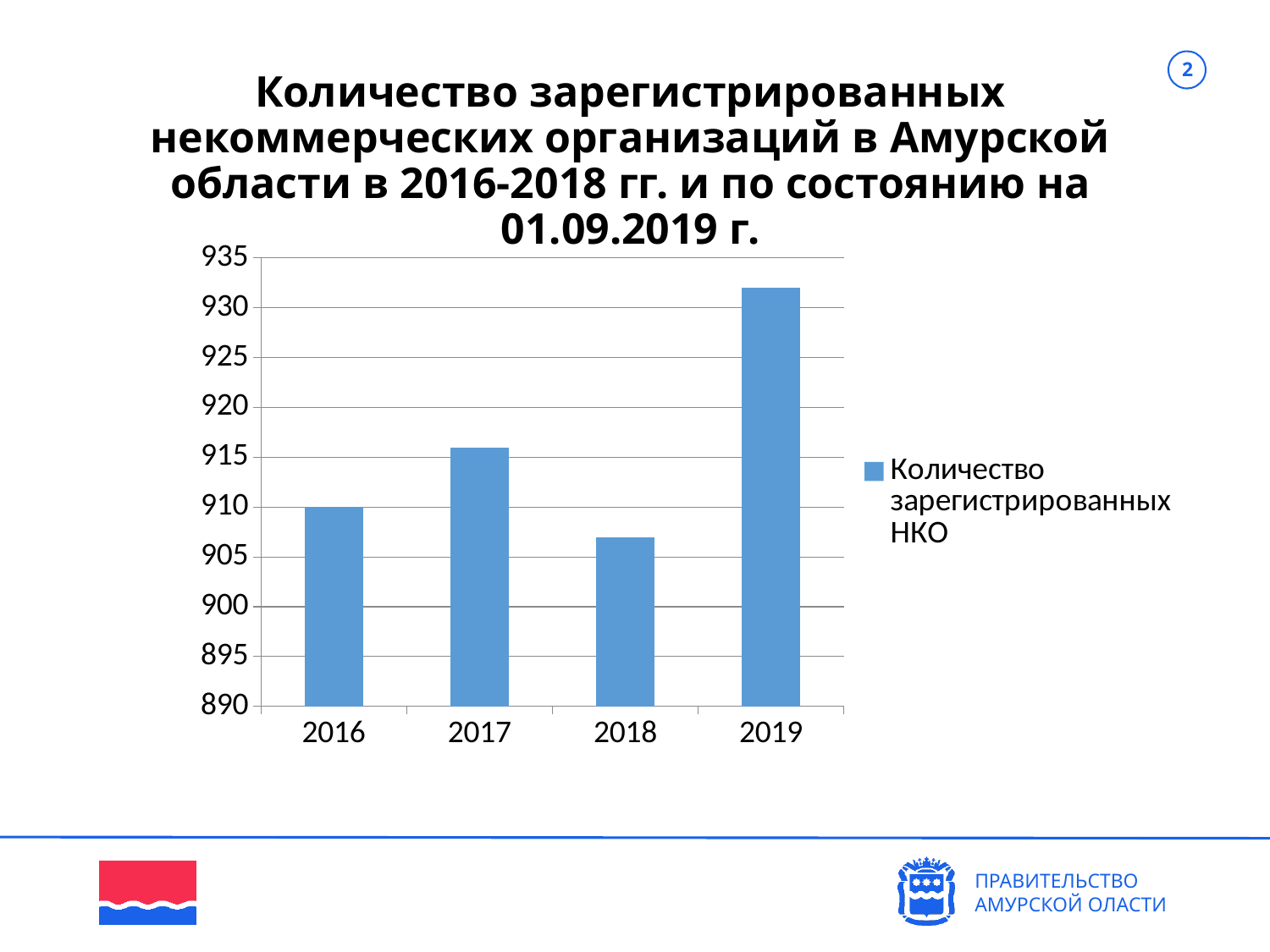
Which is larger, the value for 2016 or the value for 2019? 2019 Is the value for 2017 greater or less than 915? greater Which is larger, the value for 2017 or the value for 2018? 2017 What kind of chart is shown on the slide? bar chart What is the legend entry for the series shown in the chart? Количество зарегистрированных НКО Which year has the lowest number of registered NKOs? 2018 What is the value for 2016? 910 How many series does the legend list? 1 How many years are shown on the x axis of the chart? 4 Is the value for 2019 greater or less than 930? greater Which year has the highest number of registered NKOs? 2019 Is the value for 2018 greater or less than 910? less